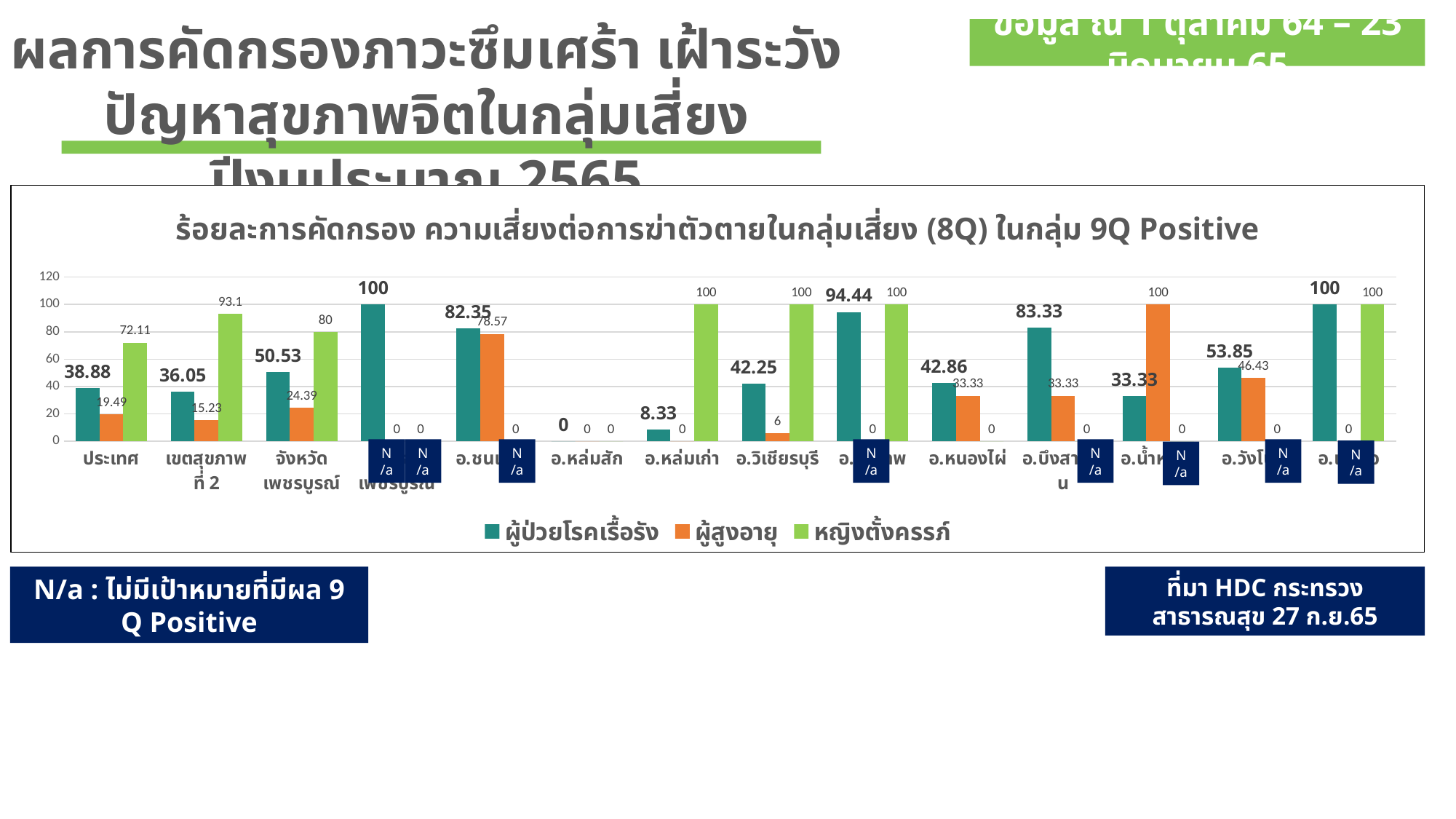
What is the difference between the หญิงตั้งครรภ์ and ผู้ป่วยโรคเรื้อรัง values in the จังหวัดเพชรบูรณ์ category? 29.47 What is the value for หญิงตั้งครรภ์ in the เขตสุขภาพที่ 2 category? 93.1 What is the value for ผู้ป่วยโรคเรื้อรัง in the ประเทศ category? 38.88 What is the value for ผู้สูงอายุ in the อ.วิเชียรบุรี category? 6 Which is larger: the ผู้ป่วยโรคเรื้อรัง value for ประเทศ or for เขตสุขภาพที่ 2? ประเทศ Which series has the lowest value in the เขตสุขภาพที่ 2 category? ผู้สูงอายุ How many series does the legend list? 3 What is the value for ผู้ป่วยโรคเรื้อรัง in the อ.หล่มเก่า category? 8.33 What is the value for ผู้สูงอายุ in the จังหวัดเพชรบูรณ์ category? 24.39 What type of chart is shown on the slide? bar chart Which series is shown in orange in the legend? ผู้สูงอายุ Which series has the highest value in the ประเทศ category? หญิงตั้งครรภ์